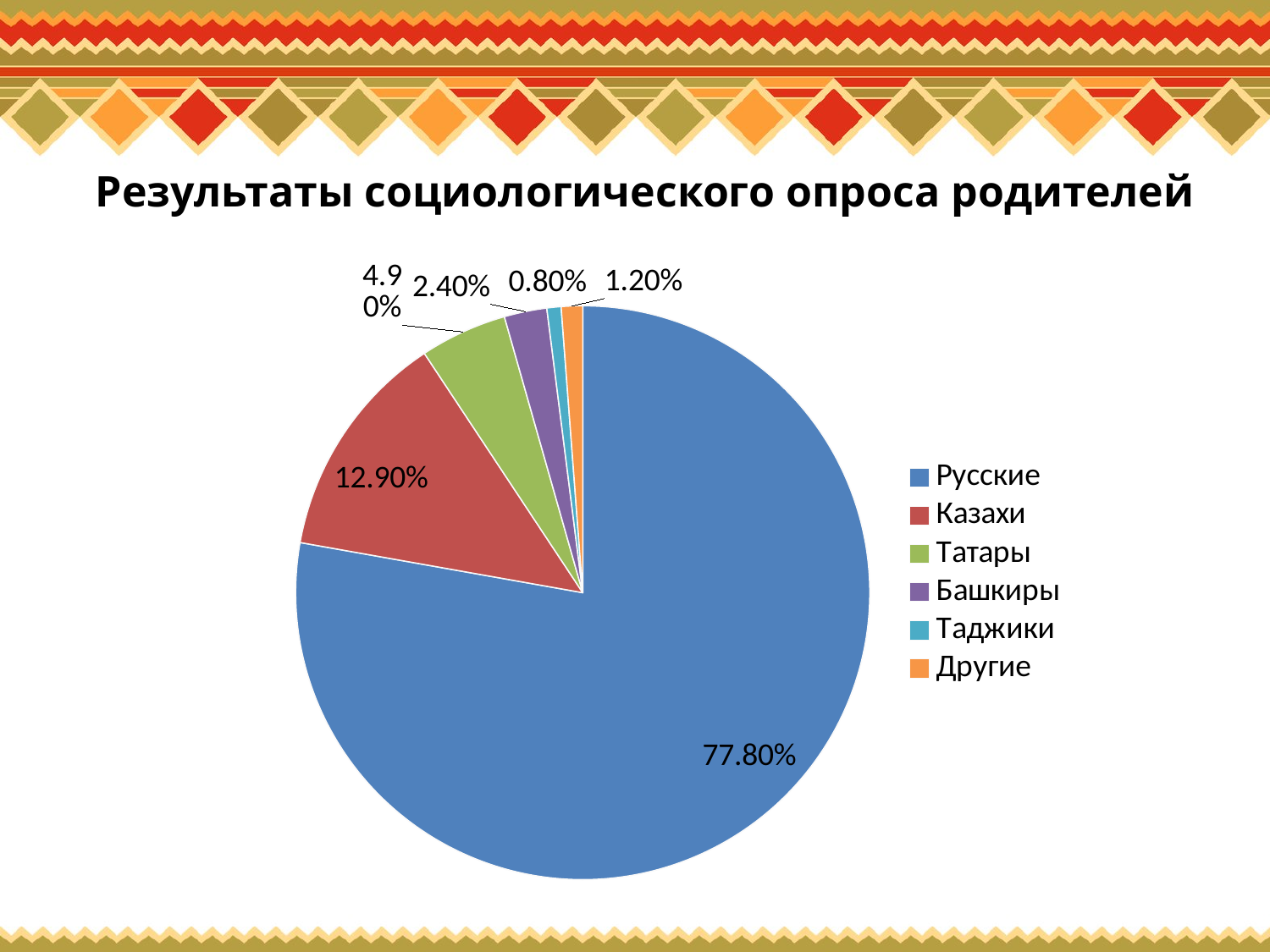
Which category has the smallest slice? Таджики Which category has the largest slice? Русские What is the share for Таджики? 0.80% What is the share for Другие? 1.20% What is the share for Русские? 77.80% What is the share for Казахи? 12.90% Which is larger, the share for Другие or the share for Таджики? Другие How many categories does the legend list? 6 What kind of chart is shown on the slide? pie chart What is the difference between the shares for Русские and Казахи? 64.90% What is the share for Татары? 4.90% What is the share for Башкиры? 2.40%